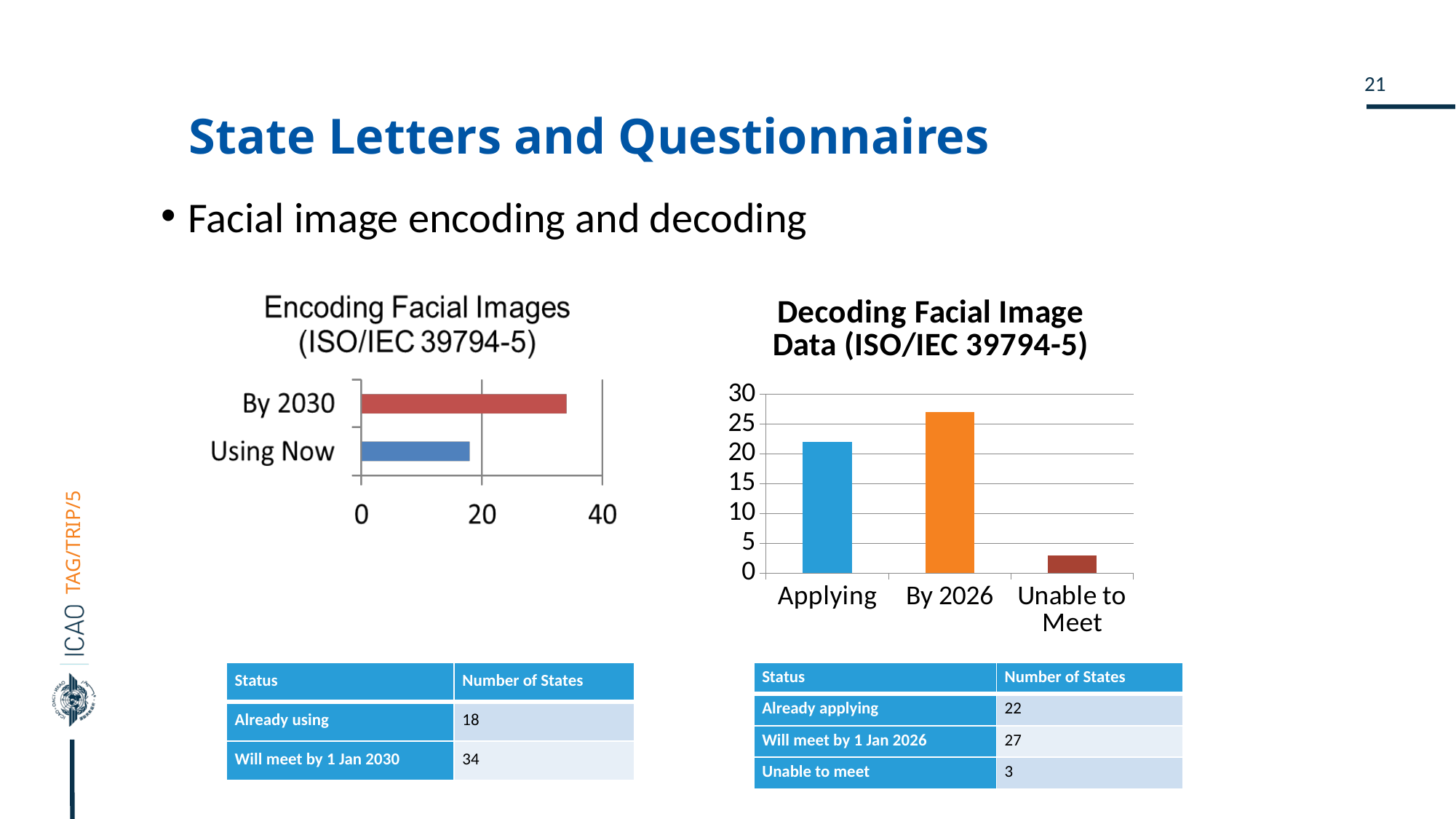
In the Decoding Facial Image Data (ISO/IEC 39794-5) chart, which category has the lowest value? Unable to Meet In the Encoding Facial Images (ISO/IEC 39794-5) chart, which category has the higher value? By 2030 In the Encoding Facial Images (ISO/IEC 39794-5) chart, how many categories are plotted? 2 In the Encoding Facial Images (ISO/IEC 39794-5) chart, what kind of chart is shown? bar chart In the Encoding Facial Images (ISO/IEC 39794-5) chart, is the value for Using Now greater or less than 20? less In the Encoding Facial Images (ISO/IEC 39794-5) chart, is the value for By 2030 greater or less than 20? greater According to the table under the Decoding Facial Image Data chart, how many States are unable to meet? 3 In the Decoding Facial Image Data (ISO/IEC 39794-5) chart, which category has the highest value? By 2026 Using the table under the Decoding Facial Image Data chart, what is the difference between the number of States that will meet by 1 Jan 2026 and those already applying? 5 In the Decoding Facial Image Data (ISO/IEC 39794-5) chart, how many categories are plotted? 3 In the Decoding Facial Image Data (ISO/IEC 39794-5) chart, is the value for Applying greater or less than 20? greater According to the table under the Encoding Facial Images chart, how many States will meet by 1 Jan 2030? 34